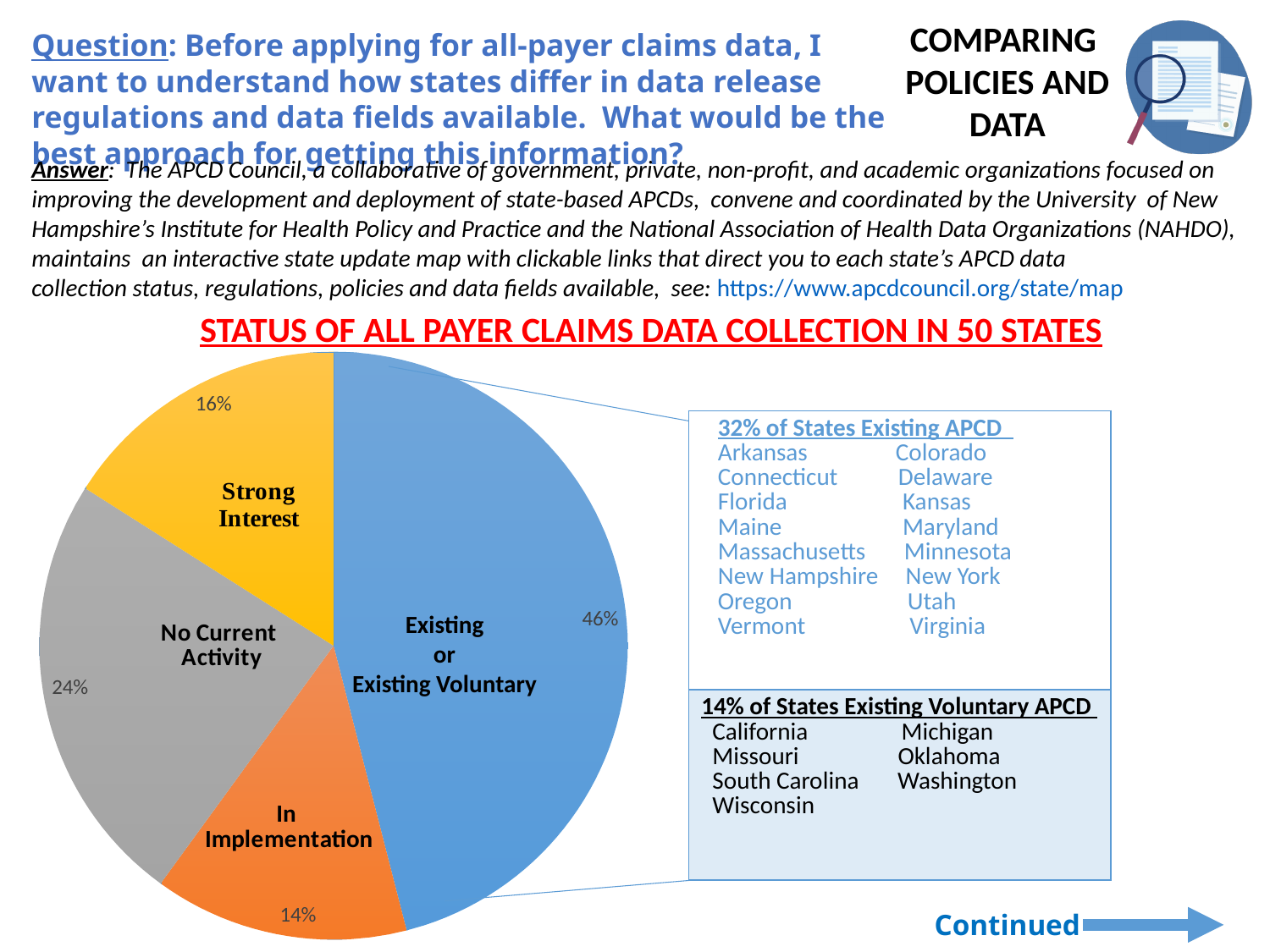
Which is larger, the 'No Current Activity' slice or the 'Strong Interest' slice? No Current Activity What is the title of the chart? STATUS OF ALL PAYER CLAIMS DATA COLLECTION IN 50 STATES What is the difference in percentage points between the 'No Current Activity' slice and the 'Strong Interest' slice? 8 What kind of chart is shown on the slide? Pie chart What percentage of the pie is labelled 'Existing or Existing Voluntary'? 46% What percentage of the pie is labelled 'In Implementation'? 14% Which slice of the pie is the smallest? In Implementation What percentage of the pie is labelled 'No Current Activity'? 24% Which slice of the pie is the largest? Existing or Existing Voluntary What percentage of the pie is labelled 'Strong Interest'? 16% What colour is the 'Existing or Existing Voluntary' slice? Blue How many slices does the pie chart have? 4